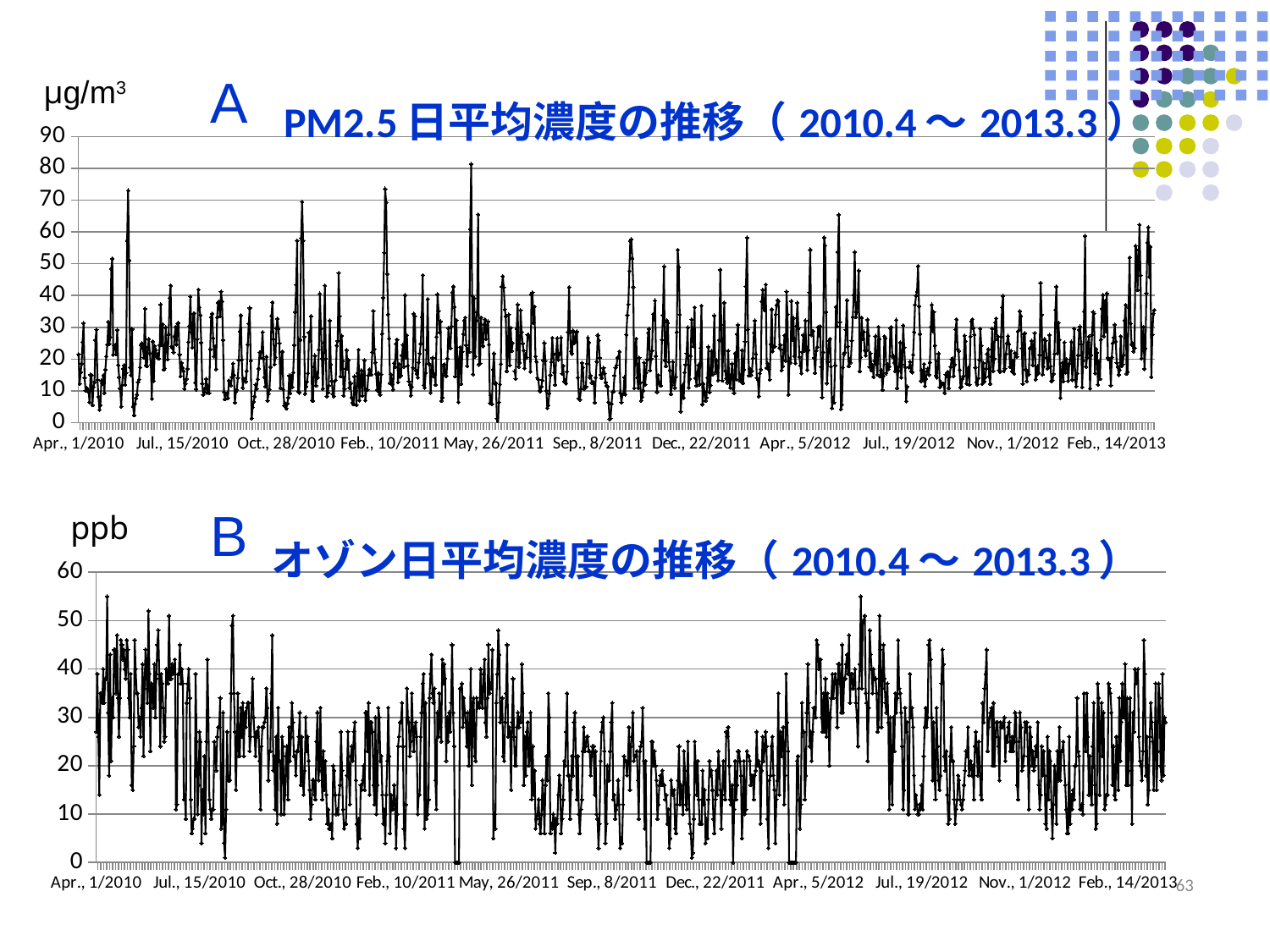
What is the highest value shown on the y axis of chart A (PM2.5 日平均濃度の推移)? 90 In chart A (PM2.5 日平均濃度の推移), is the highest peak of the series greater or less than 90? less What is the first date label on the x axis of chart A (PM2.5 日平均濃度の推移)? Apr., 1/2010 How many date labels are printed along the x axis of chart B (オゾン日平均濃度の推移)? 11 In chart B (オゾン日平均濃度の推移), is the highest peak of the series greater or less than 50? greater In chart B (オゾン日平均濃度の推移), is the highest peak of the series greater or less than 60? less What unit is shown on the y axis of chart B (オゾン日平均濃度の推移)? ppb What unit is shown on the y axis of chart A (PM2.5 日平均濃度の推移)? µg/m³ What kind of chart is chart B (オゾン日平均濃度の推移)? line chart What kind of chart is chart A (PM2.5 日平均濃度の推移)? line chart What is the highest value shown on the y axis of chart B (オゾン日平均濃度の推移)? 60